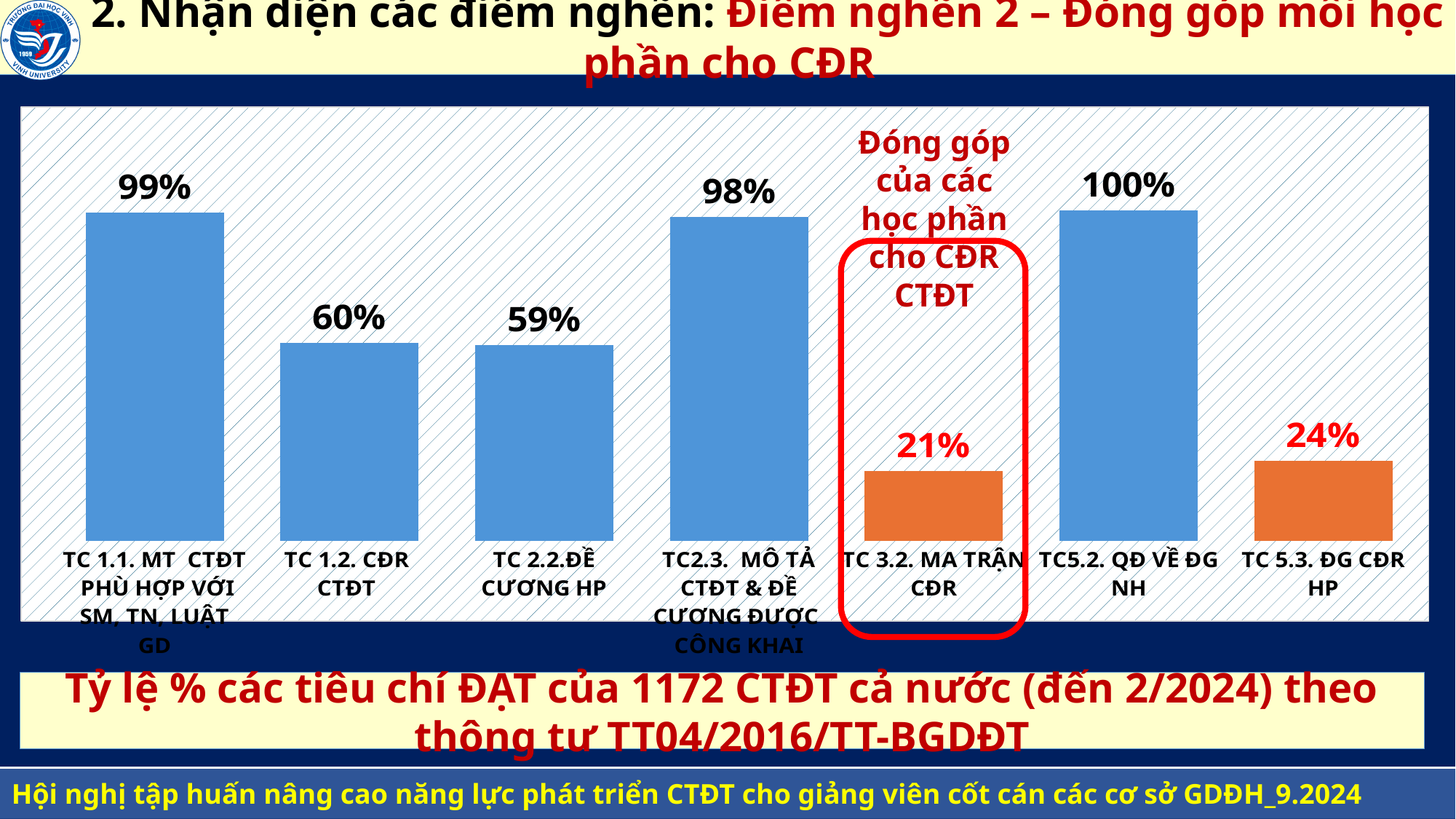
Which category has the lowest value? TC 3.2. MA TRẬN CĐR What is the value for TC 3.2. MA TRẬN CĐR? 21% How many categories (bars) does the chart show? 7 What is the value for TC2.3. MÔ TẢ CTĐT & ĐỀ CƯƠNG ĐƯỢC CÔNG KHAI? 98% What type of chart is shown on the slide? Bar chart Which two bars are coloured orange instead of blue? TC 3.2. MA TRẬN CĐR and TC 5.3. ĐG CĐR HP Which category has the highest value? TC5.2. QĐ VỀ ĐG NH What is the difference between the values for TC 5.3. ĐG CĐR HP and TC 3.2. MA TRẬN CĐR? 3% What is the difference between the values for TC 1.1. MT CTĐT PHÙ HỢP VỚI SM, TN, LUẬT GD and TC 1.2. CĐR CTĐT? 39% What is the value for TC 1.2. CĐR CTĐT? 60% What is the value for TC 5.3. ĐG CĐR HP? 24% Which is larger, the value for TC 2.2. ĐỀ CƯƠNG HP or the value for TC 5.3. ĐG CĐR HP? TC 2.2. ĐỀ CƯƠNG HP